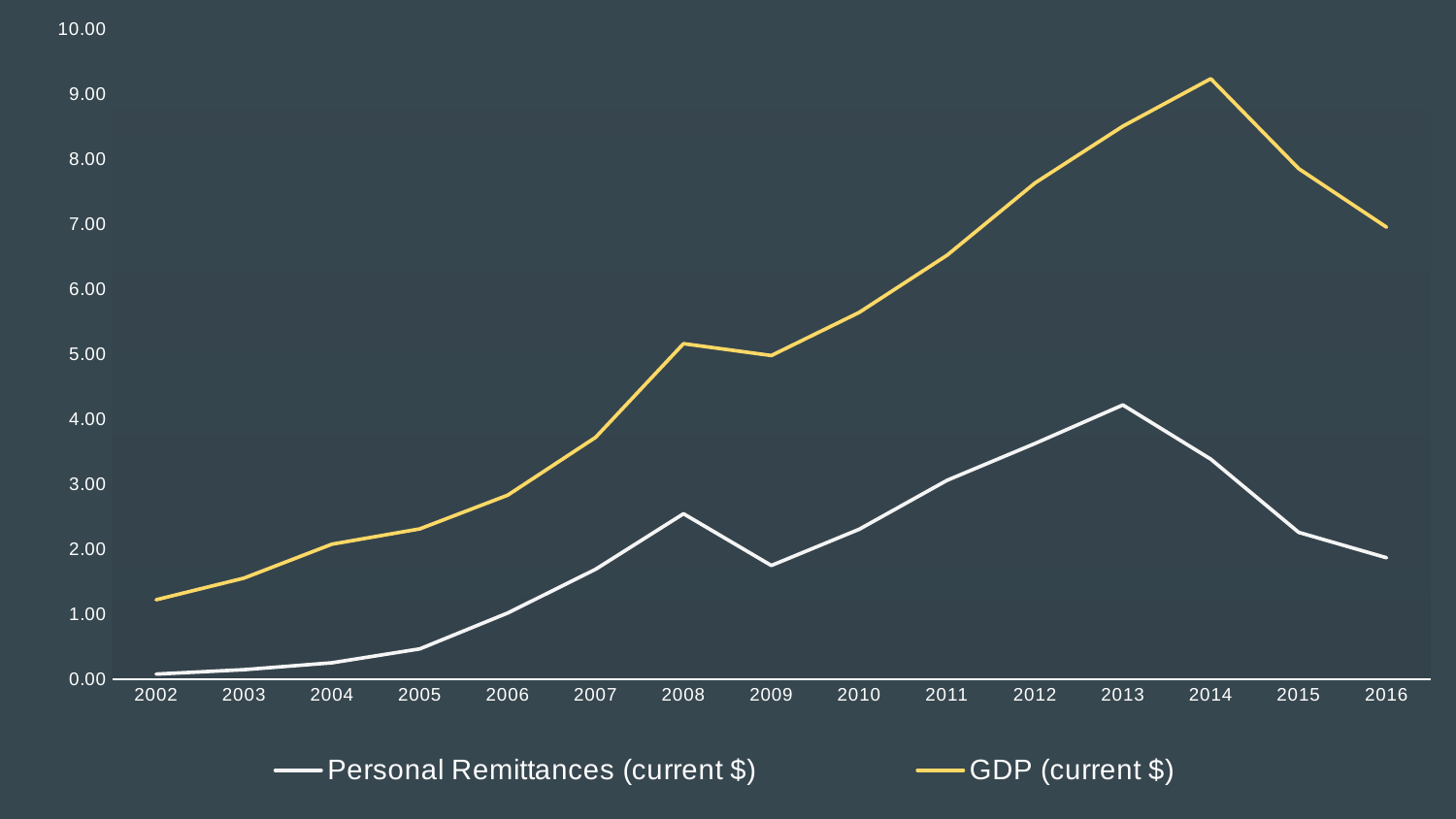
Which series is higher in 2010, Personal Remittances (current $) or GDP (current $)? GDP (current $) How many series does the legend list? 2 How many years are shown on the x axis? 15 What kind of chart is shown on the slide? line chart In which year is GDP (current $) at its lowest? 2002 In which year does Personal Remittances (current $) reach its highest value? 2013 In which year does GDP (current $) reach its highest value? 2014 Is the value for Personal Remittances (current $) in 2009 greater or less than 2.00? less Does GDP (current $) rise or fall from 2014 to 2016? fall Is the value for GDP (current $) in 2012 greater or less than 7.00? greater Is the value for GDP (current $) in 2014 greater or less than 9.00? greater Which colour is used for the GDP (current $) line? yellow